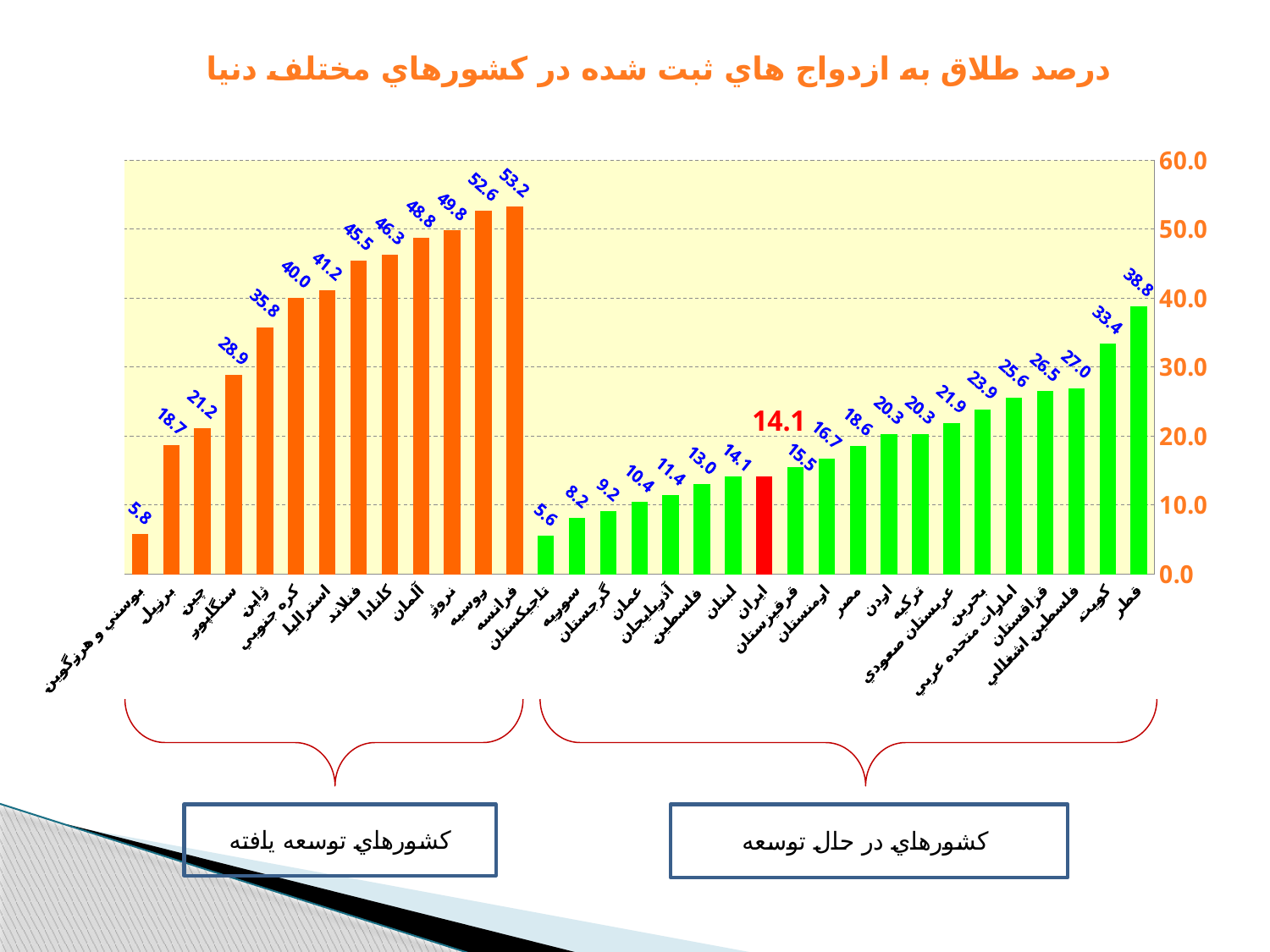
What is the value shown for ایران (Iran), the red bar? 14.1 Which bar is highlighted in red on the chart? ایران (Iran) Which has a larger value, کویت (Kuwait) or ژاپن (Japan)? ژاپن (Japan) How many countries (bars) are shown on the chart? 33 What is the difference between the values for روسیه (Russia) and ایران (Iran)? 38.5 What is the value shown for فرانسه (France)? 53.2 Which country has the highest value on the chart? فرانسه (France) Is the value for آلمان (Germany) greater or less than 40.0? greater What kind of chart is shown on the slide? bar chart What is the value shown for قطر (Qatar)? 38.8 What is the value shown for بوسنی و هرزگوین (Bosnia and Herzegovina)? 5.8 Which country has the lowest value on the chart? تاجیکستان (Tajikistan)